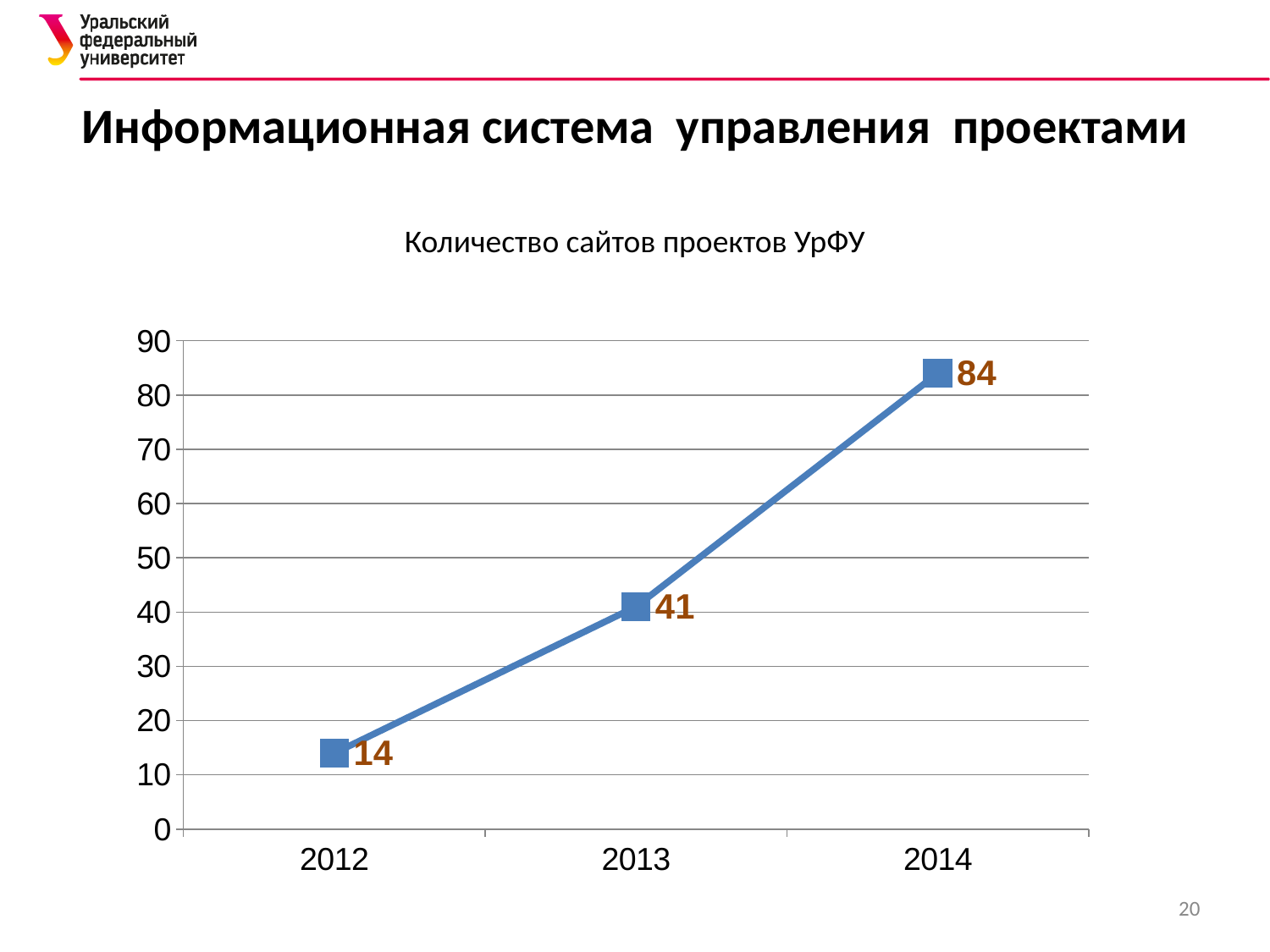
Which is larger, the value for 2013 or the value for 2012? 2013 What kind of chart is shown on the slide? line chart What is the value for 2013? 41 What is the difference between the values for 2014 and 2013? 43 Which year has the highest value? 2014 What is the value for 2012? 14 Which year has the lowest value? 2012 Do the values rise or fall from 2012 to 2014? rise Is the value for 2014 greater or less than 80? greater What is the difference between the values for 2013 and 2012? 27 What is the value for 2014? 84 How many data points are plotted on the chart? 3